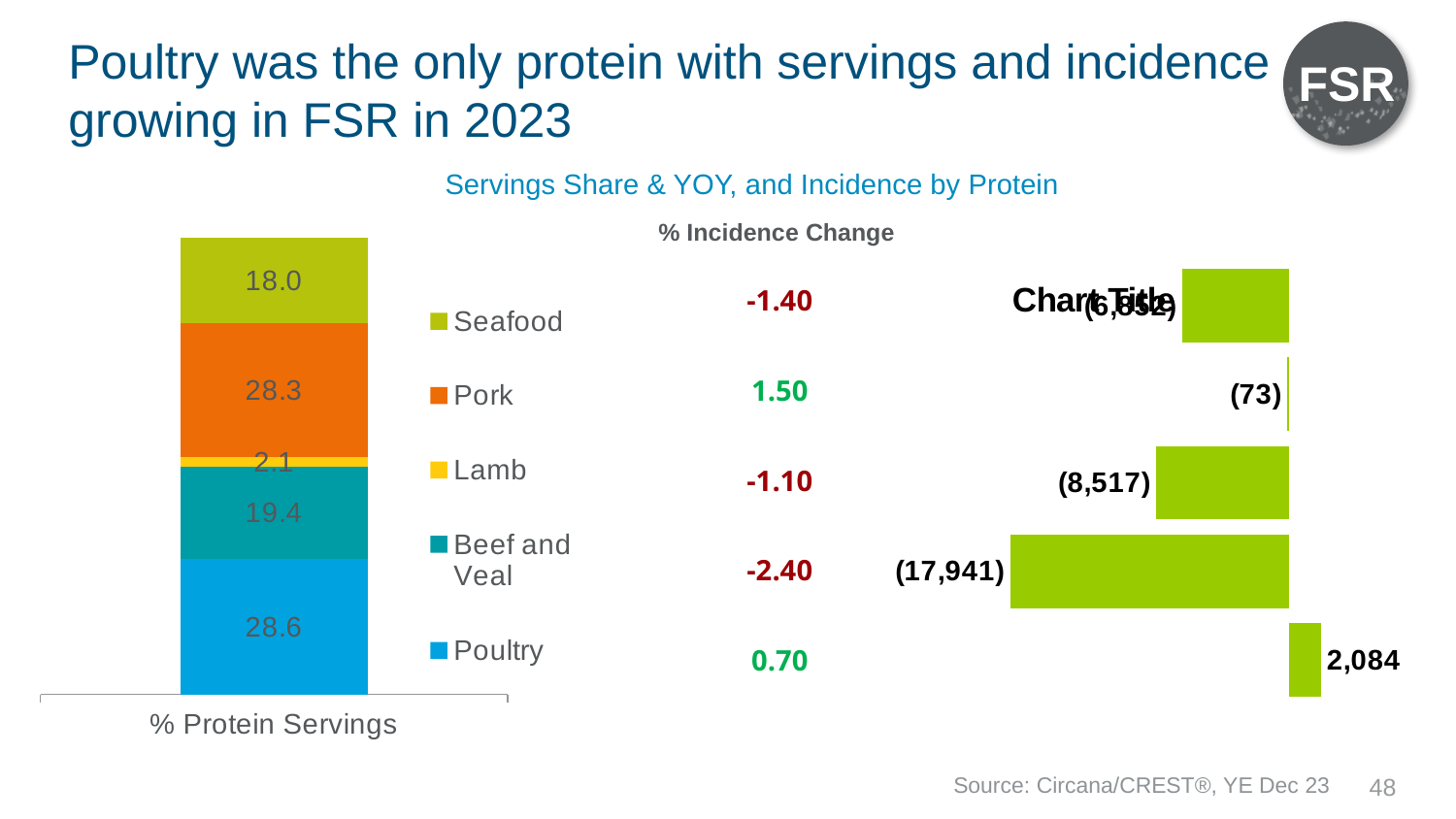
What is the % Incidence Change value shown for Pork? 1.50 In the stacked bar chart labelled % Protein Servings, what is the value for Pork? 28.3 In the stacked bar chart labelled % Protein Servings, what is the value for Lamb? 2.1 In the stacked bar chart labelled % Protein Servings, what is the difference between the Pork and Seafood values? 10.3 What kind of chart is the % Protein Servings chart? Stacked bar chart In the stacked bar chart labelled % Protein Servings, what is the value for Poultry? 28.6 What is the % Incidence Change value shown for Beef and Veal? -2.40 In the stacked bar chart labelled % Protein Servings, which is larger, the Beef and Veal value or the Seafood value? Beef and Veal In the horizontal bar chart on the right, what is the value shown for the Beef and Veal bar? (17,941) In the horizontal bar chart on the right, what is the value shown for the bottom bar (Poultry)? 2,084 In the stacked bar chart labelled % Protein Servings, which protein has the smallest share? Lamb How many proteins does the legend of the % Protein Servings chart list? 5